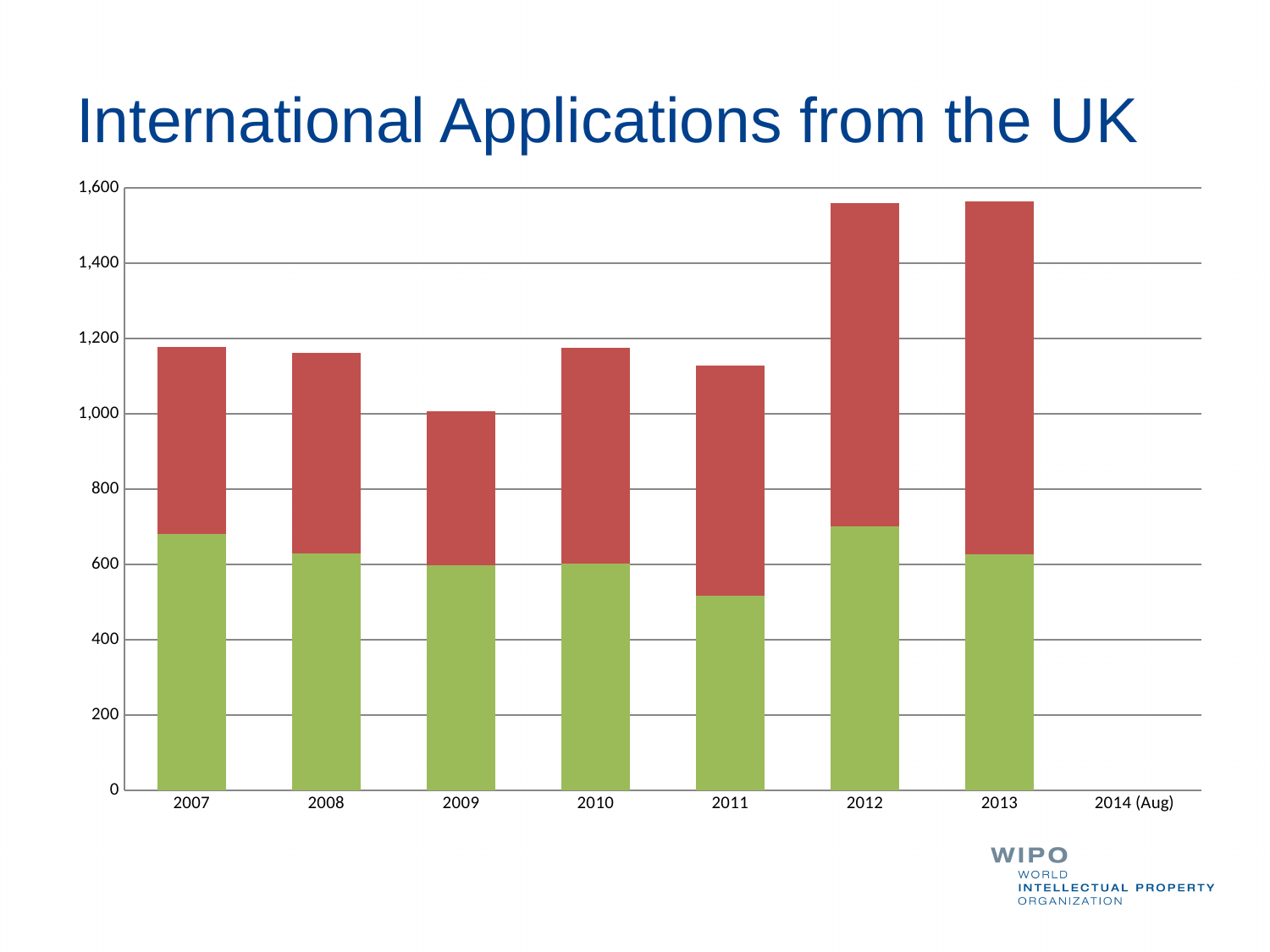
Is the green segment for 2007 greater or less than 600? greater Which year has the smallest green segment? 2011 Is the green segment for 2011 greater or less than 600? less Which year has the taller total bar, 2011 or 2012? 2012 Is the total bar height for 2009 greater or less than 1,200? less How many years have bars plotted in the chart? 7 Which year has the lowest total bar height? 2009 Between 2011 and 2012, did the total bar height rise or fall? rise What is the title of the chart? International Applications from the UK Which x-axis category has no bar plotted? 2014 (Aug) What kind of chart is shown on the slide? Stacked bar chart